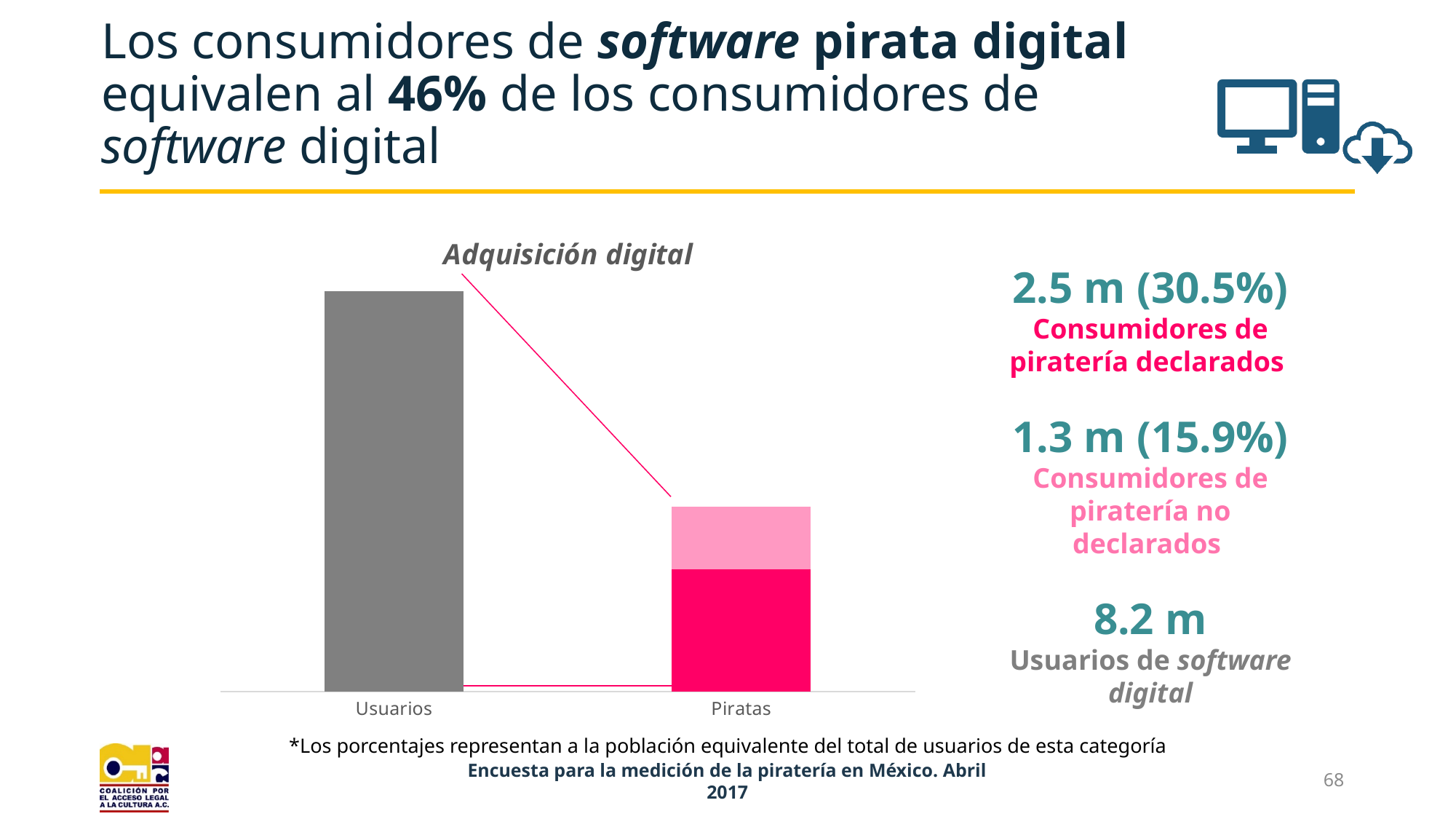
What kind of chart is shown on the slide? bar chart According to the slide, how many declared piracy consumers (Consumidores de piratería declarados) are there? 2.5 m What percentage of digital software users are declared piracy consumers? 30.5% What is the title of the chart? Adquisición digital According to the slide, how many users of digital software (Usuarios de software digital) are there? 8.2 m Which category has the lowest bar in the chart? Piratas Which category has the taller bar, Usuarios or Piratas? Usuarios What percentage of digital software users are undeclared piracy consumers (Consumidores de piratería no declarados)? 15.9% Which segment of the Piratas bar is larger, the dark pink (declared) or the light pink (undeclared)? dark pink (declared) What is the total number of piracy consumers represented by the stacked Piratas bar (declared plus undeclared)? 3.8 m How many categories are shown on the x axis of the chart? 2 What is the difference in millions between digital software users (8.2 m) and declared piracy consumers (2.5 m)? 5.7 m